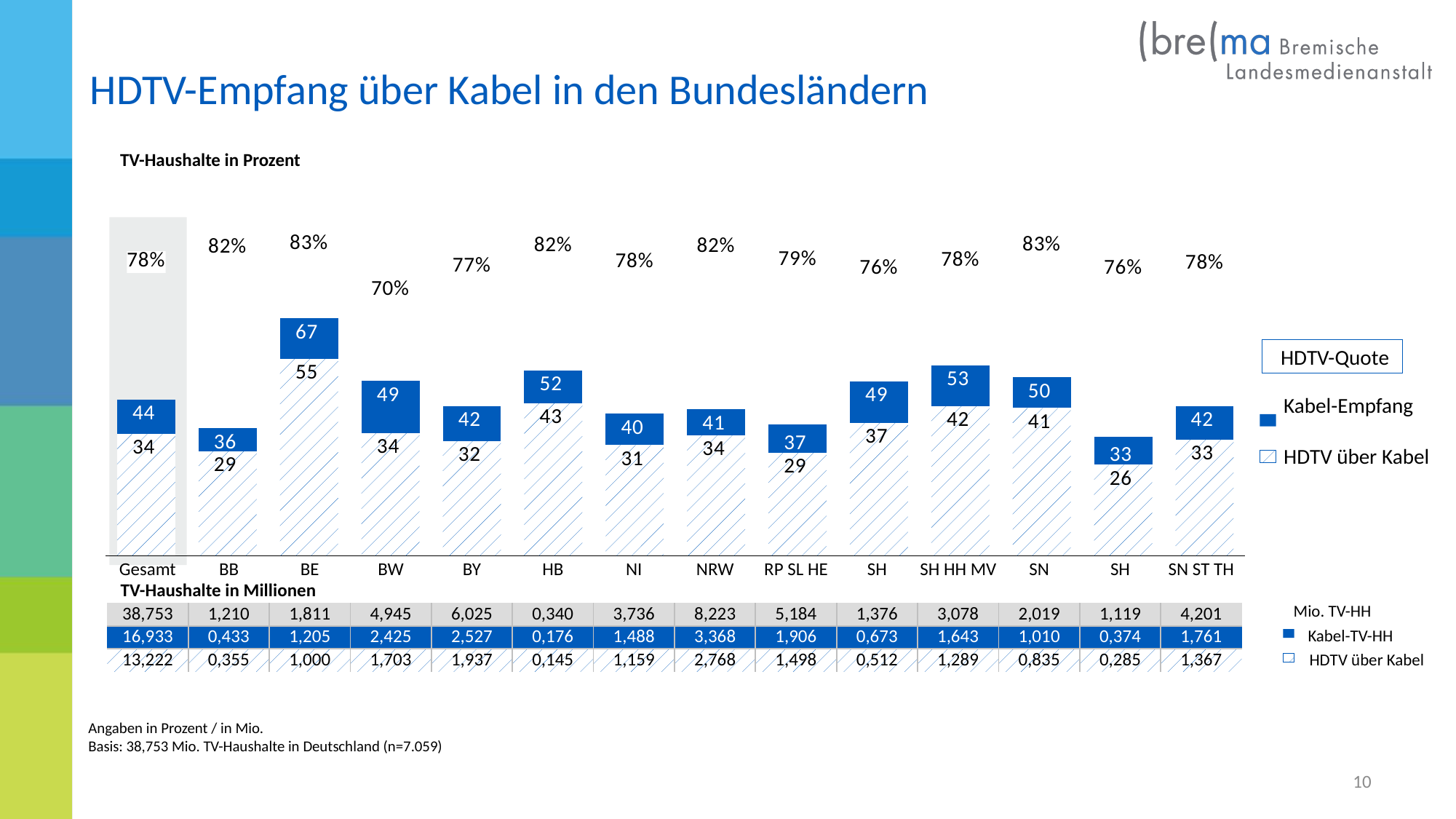
What is the Kabel-Empfang value for BE? 67 What is the difference between the Kabel-Empfang and HDTV über Kabel values for Gesamt? 10 What is the title of the slide? HDTV-Empfang über Kabel in den Bundesländern How many categories are shown on the x axis of the chart? 14 What kind of chart is shown on the slide? Bar chart What is the difference between the Kabel-Empfang and HDTV über Kabel values for BE? 12 Which category has the highest Kabel-Empfang value? BE In the table below the chart, how many Kabel-TV-HH (in millions) are listed for NRW? 3,368 Which has the higher Kabel-Empfang value, HB or BW? HB Which category has the lowest HDTV-Quote? BW What is the HDTV-Quote shown for BW? 70% What is the HDTV über Kabel value for NRW? 34